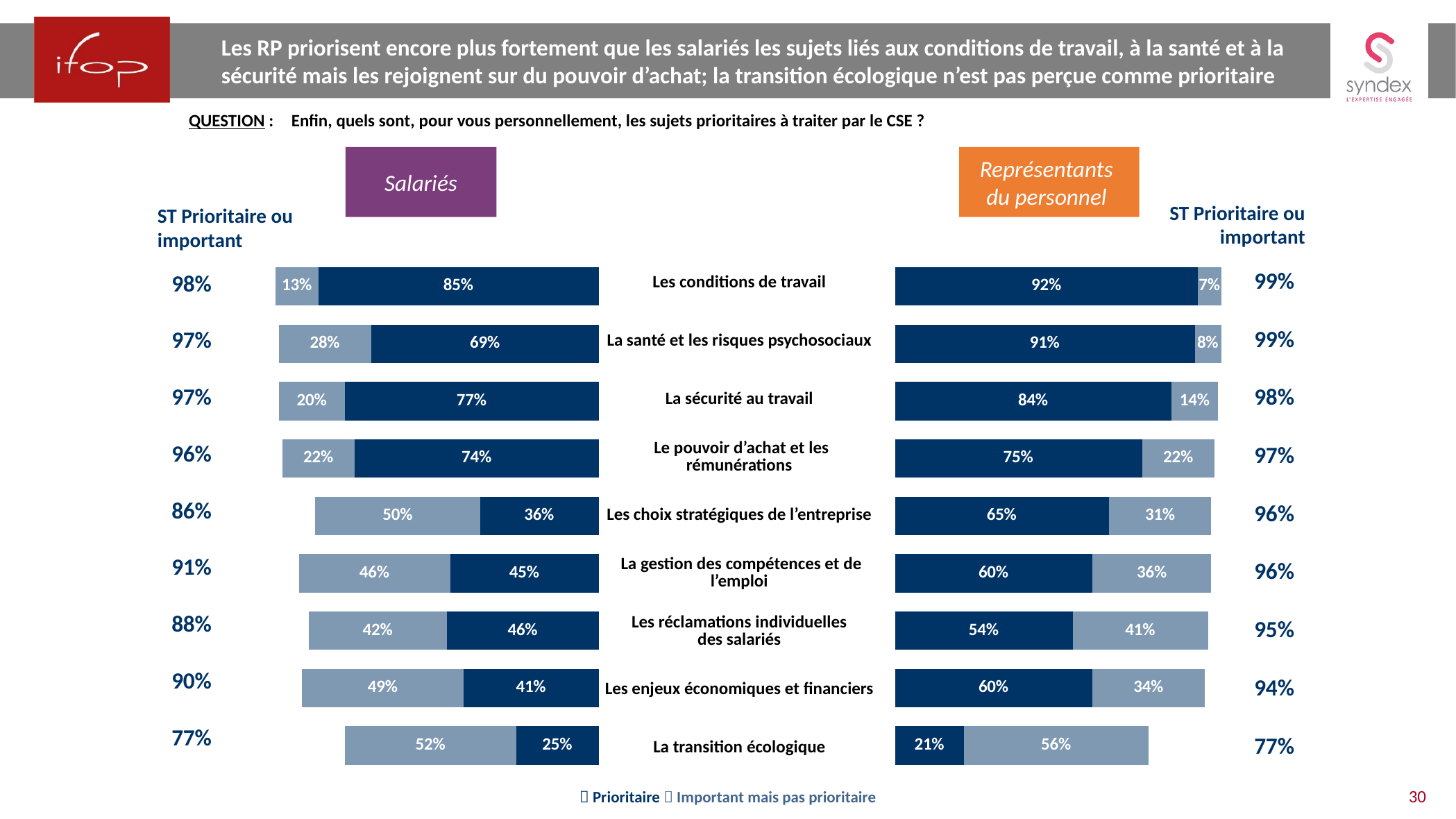
What type of chart is used for the Représentants du personnel data? Stacked bar chart How many topics are listed in the Salariés chart? 9 How many series does the legend at the bottom of the slide list? 2 In the Représentants du personnel chart, what percentage rate 'La transition écologique' as 'Important mais pas prioritaire'? 56% In the Salariés chart, what is the difference between the 'Prioritaire' percentages for 'La sécurité au travail' and 'Le pouvoir d'achat et les rémunérations'? 3% Comparing the two charts, is the 'Prioritaire' percentage for 'Les choix stratégiques de l'entreprise' higher among Salariés or among Représentants du personnel? Représentants du personnel In the Représentants du personnel chart, what is the 'ST Prioritaire ou important' total for 'Les enjeux économiques et financiers'? 94% In the Salariés chart, what is the 'ST Prioritaire ou important' total for 'La gestion des compétences et de l'emploi'? 91% In the Salariés chart, which topic has the lowest 'Prioritaire' percentage? La transition écologique In the Représentants du personnel chart, which topic has the highest 'Prioritaire' percentage? Les conditions de travail In the Salariés chart, what percentage of employees consider 'Les conditions de travail' as 'Prioritaire'? 85% Which colour represents the 'Prioritaire' series in the charts? Dark blue